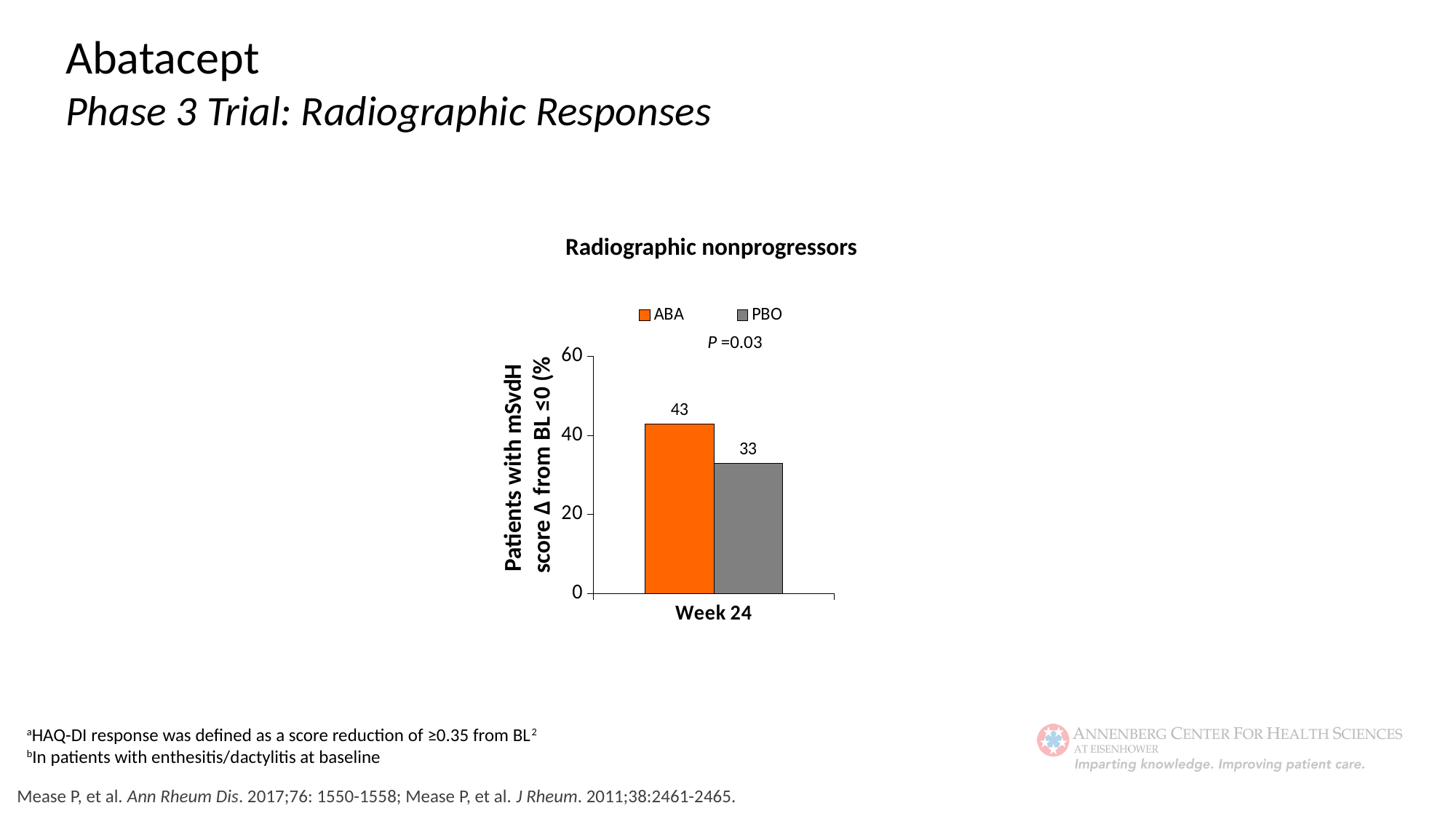
What kind of chart is shown? Bar chart Which series has the lower value at Week 24? PBO Is the value for ABA greater or less than 40? greater What is the value for PBO at Week 24? 33 What is the value for ABA at Week 24? 43 Is the value for PBO greater or less than 40? less How many series does the legend list? 2 What is the difference between the ABA and PBO values at Week 24? 10 What P value is shown on the chart? P =0.03 What is the title of the chart? Radiographic nonprogressors Which series has the higher value at Week 24? ABA How many categories are shown on the x axis? 1